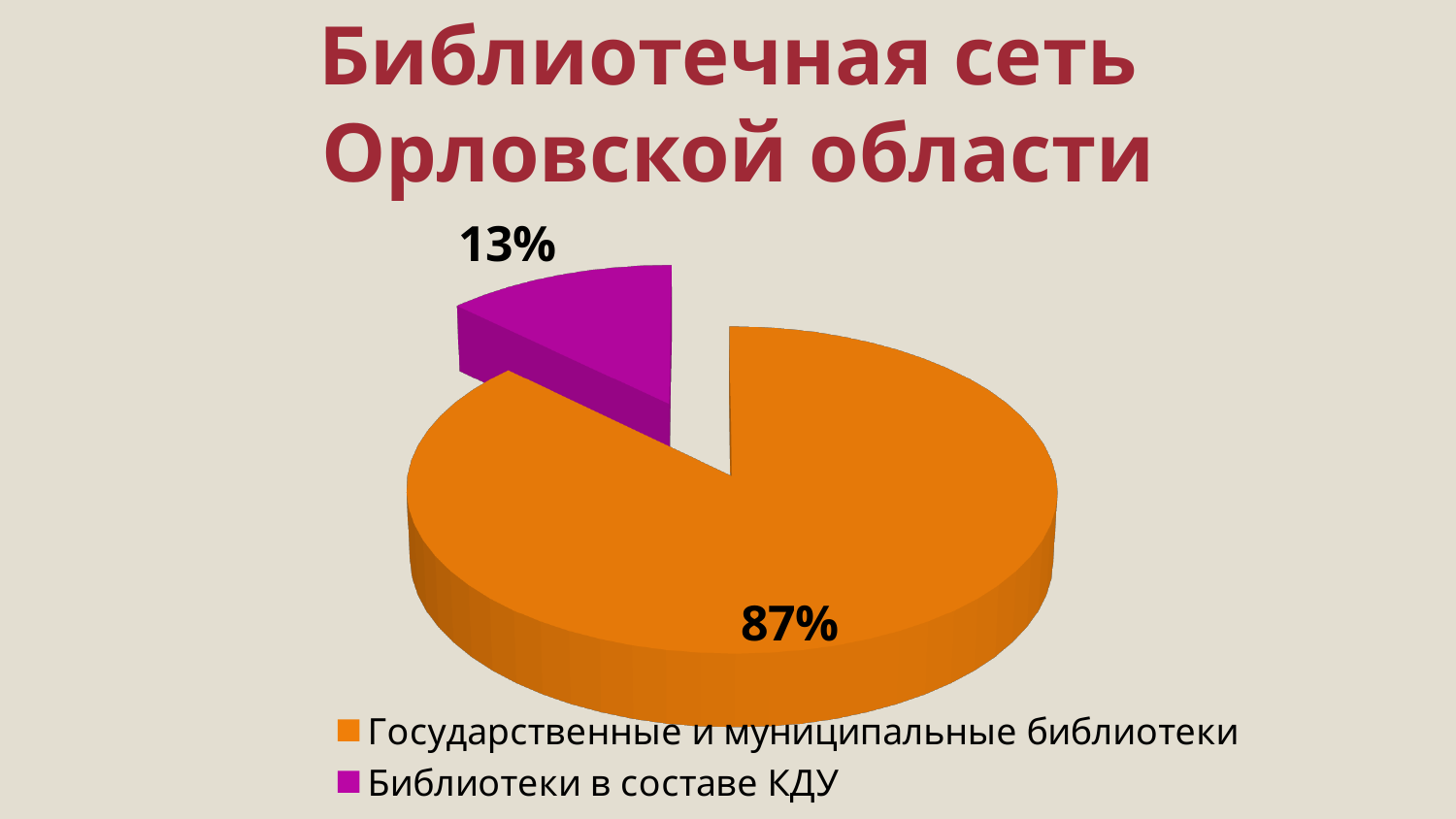
How many slices does the pie chart have? 2 Which category has the largest slice of the pie? Государственные и муниципальные библиотеки What share of the pie is labelled for Библиотеки в составе КДУ? 13% Which is larger: the share for Государственные и муниципальные библиотеки or the share for Библиотеки в составе КДУ? Государственные и муниципальные библиотеки What colour is the slice for Библиотеки в составе КДУ? Purple What is the title of the slide? Библиотечная сеть Орловской области Which category has the smallest slice of the pie? Библиотеки в составе КДУ What kind of chart is shown on the slide? Pie chart How many entries does the legend list? 2 What is the total of the two percentages shown on the pie? 100% What is the difference in percentage points between the two slices? 74 What share of the pie is labelled for Государственные и муниципальные библиотеки? 87%